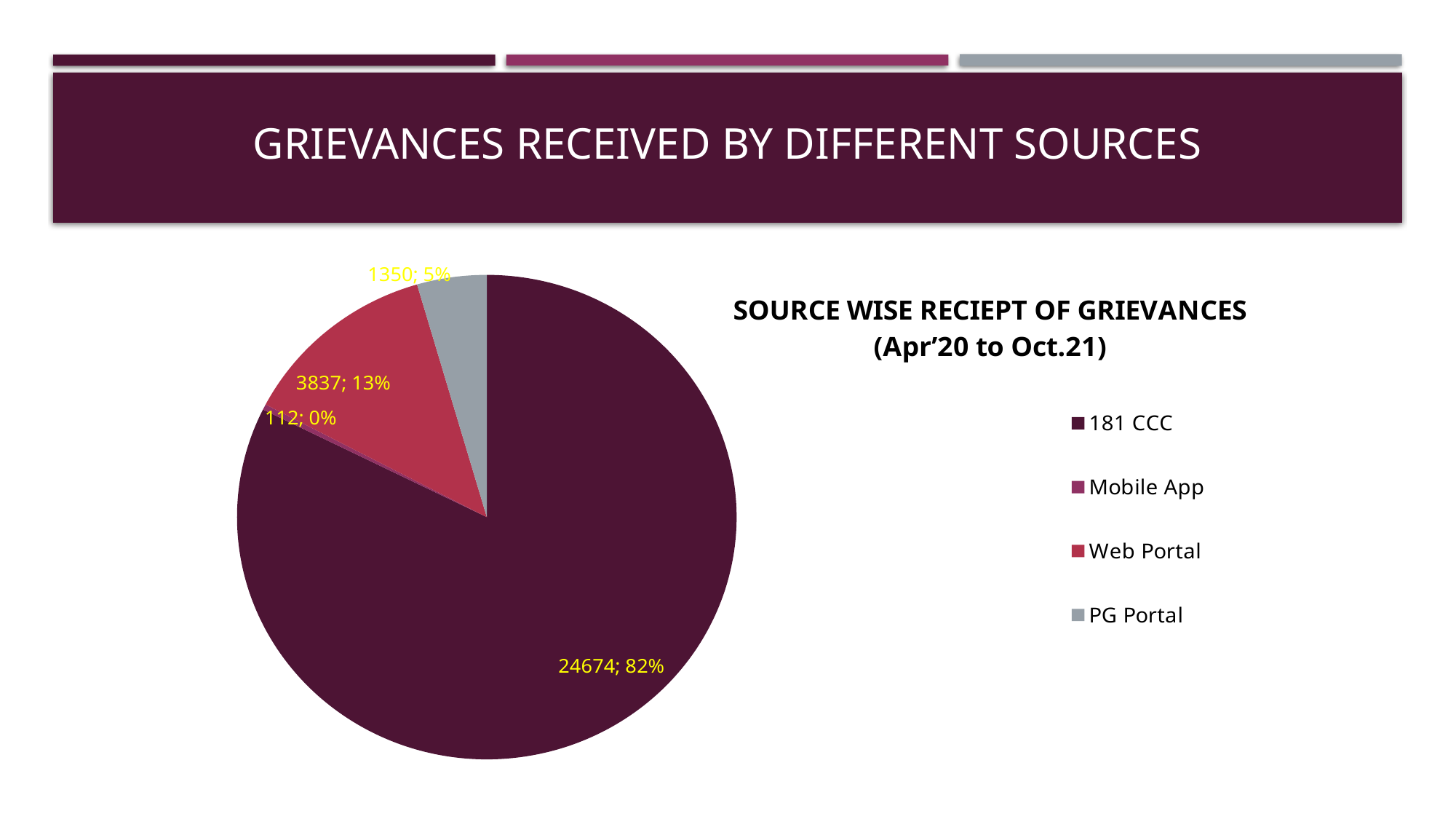
How many grievances were received via 181 CCC? 24674 Which source received the fewest grievances? Mobile App What share of grievances came from 181 CCC? 82% How many grievances were received via the PG Portal? 1350 What is the title of the chart? SOURCE WISE RECIEPT OF GRIEVANCES (Apr'20 to Oct.21) How many grievances were received via the Mobile App? 112 What share of grievances came from the Web Portal? 13% How many sources does the legend list? 4 How many grievances were received via the Web Portal? 3837 Which source received the most grievances? 181 CCC What kind of chart is shown on the slide? Pie chart What is the difference between the number of grievances from the Web Portal and from the PG Portal? 2487